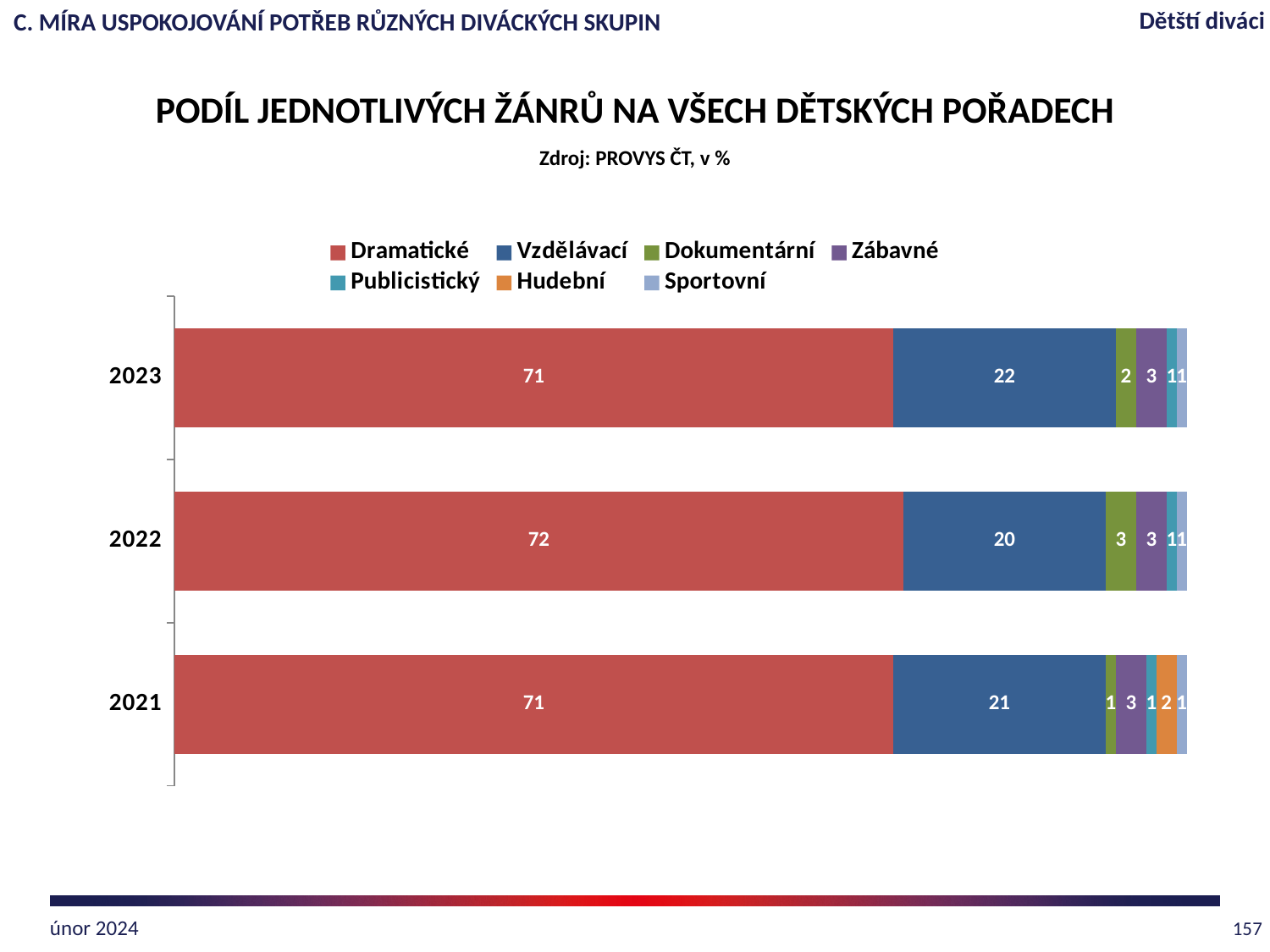
In which year is the Dramatické share highest? 2022 In which year is the Vzdělávací share lowest? 2022 How many series does the legend list? 7 Which is larger, the Dokumentární value in 2023 or in 2022? 2022 What is the difference between the Vzdělávací values for 2023 and 2022? 2 What is the value for Vzdělávací in 2023? 22 What is the value for Dramatické in 2022? 72 What is the value for Dokumentární in 2022? 3 What is the total of the stacked bar for 2021? 100 How many years are shown on the chart? 3 What is the value for Hudební in 2021? 2 What kind of chart is shown? Stacked bar chart